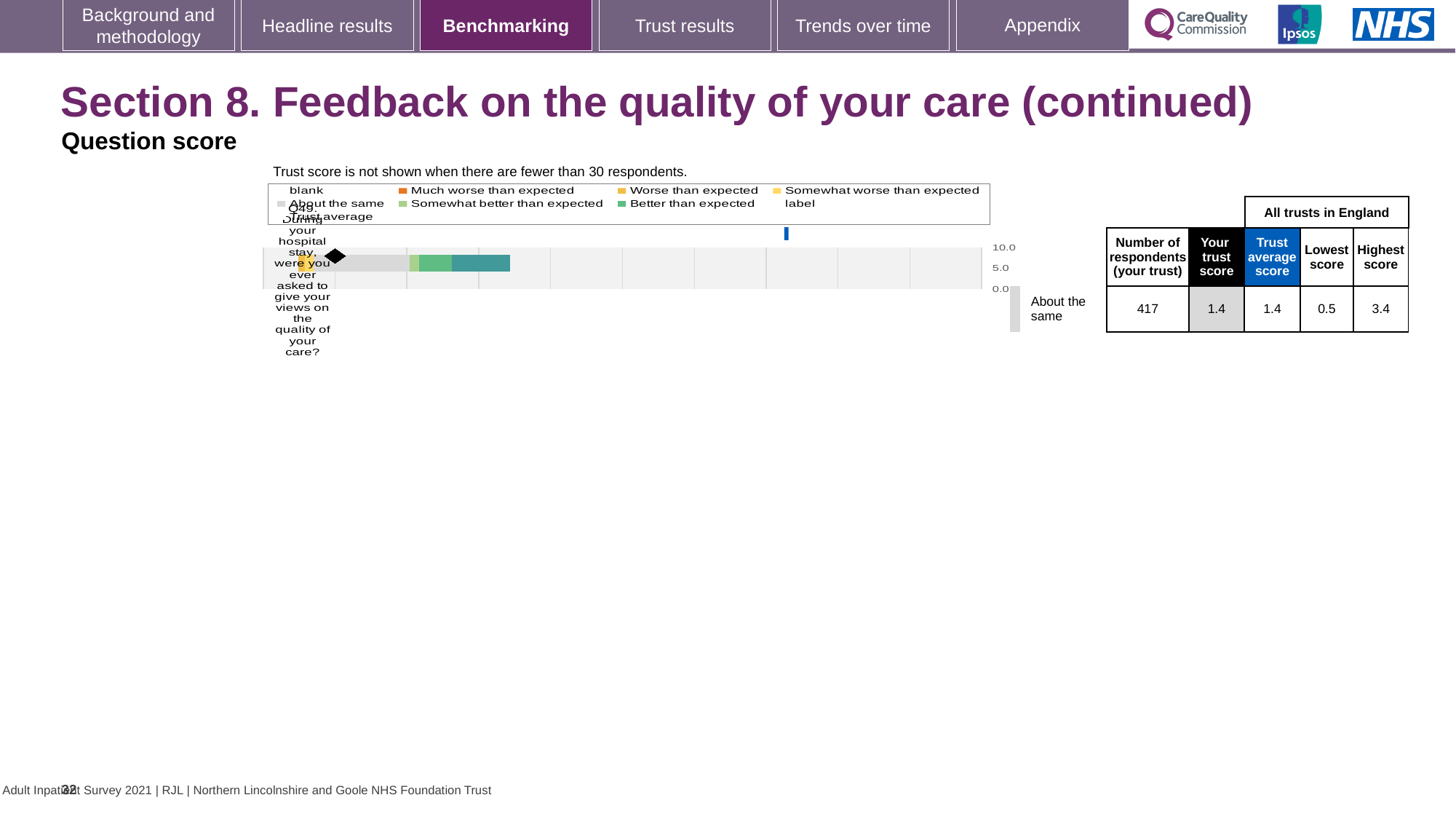
In the table beside the chart, what is your trust score for Q49? 1.4 Which question is plotted on the chart? Q49. During your hospital stay, were you ever asked to give your views on the quality of your care? How many questions (categories) are plotted on the chart? 1 What kind of chart is shown on the slide? bar chart In the table beside the chart, what is the highest score across all trusts in England? 3.4 In the table beside the chart, what is the trust average score for Q49? 1.4 Is your trust score for Q49 larger or smaller than the highest score across all trusts in England? smaller What is the difference between the highest score and the lowest score across all trusts in England? 2.9 In the table beside the chart, what is the lowest score across all trusts in England? 0.5 What is the highest value shown on the chart's axis? 10.0 In the table beside the chart, what is the number of respondents for your trust? 417 What benchmark category is shown next to the chart for Q49? About the same